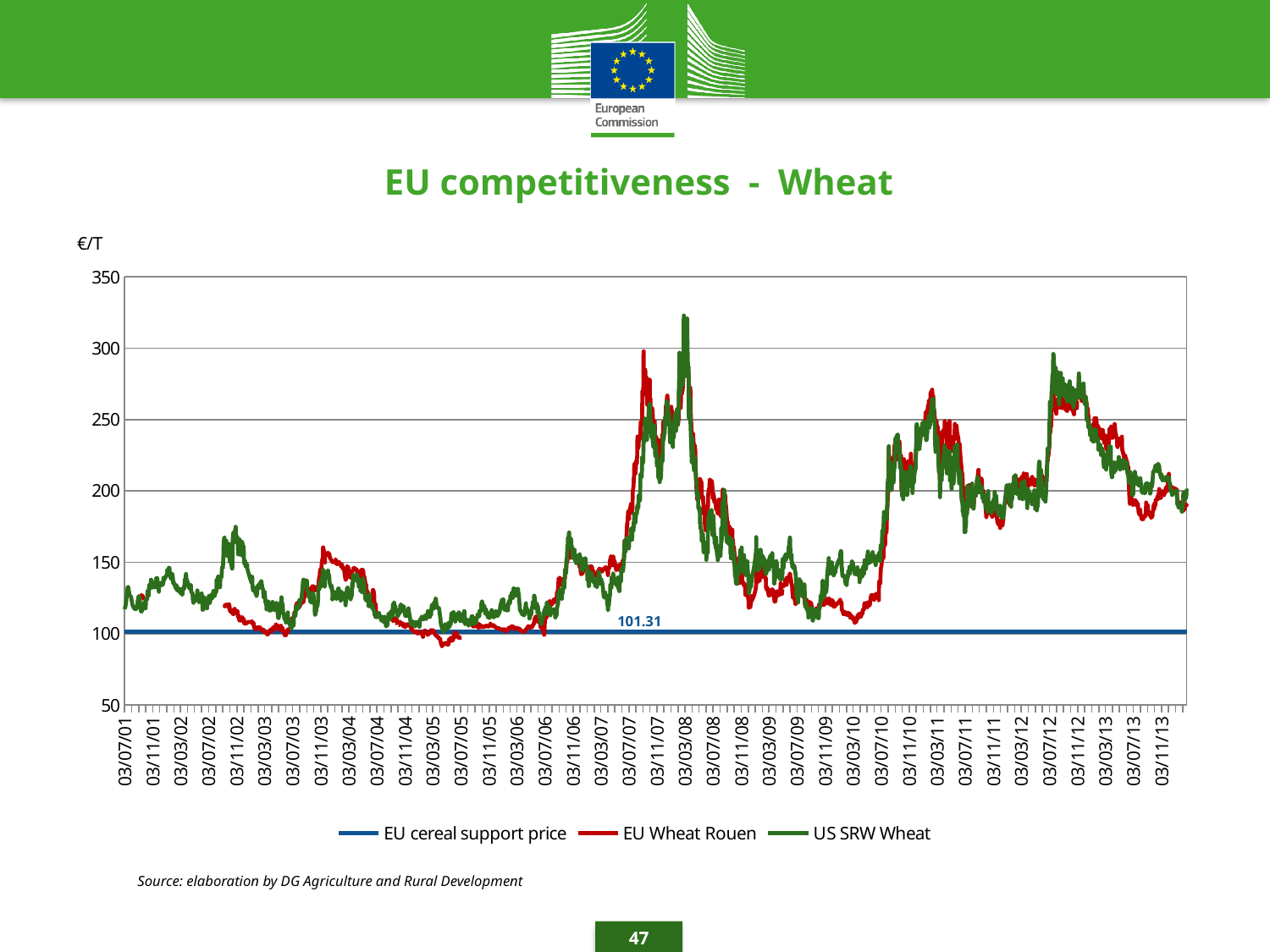
Which series reaches the highest peak on the chart? US SRW Wheat Is the value of US SRW Wheat at 03/07/01 greater or less than 150? less Around 03/03/08, which is larger: US SRW Wheat or EU Wheat Rouen? US SRW Wheat What type of chart is shown on the slide? Line chart What value is labelled on the EU cereal support price line? 101.31 What unit is shown on the y axis of the chart? €/T Is the peak value of US SRW Wheat around 03/03/08 greater or less than 300? greater Which series stays constant across the whole period? EU cereal support price How many series does the legend list? 3 Is the value of EU Wheat Rouen around 03/03/10 greater or less than 150? less Do the EU Wheat Rouen values rise or fall between 03/11/12 and 03/11/13? fall